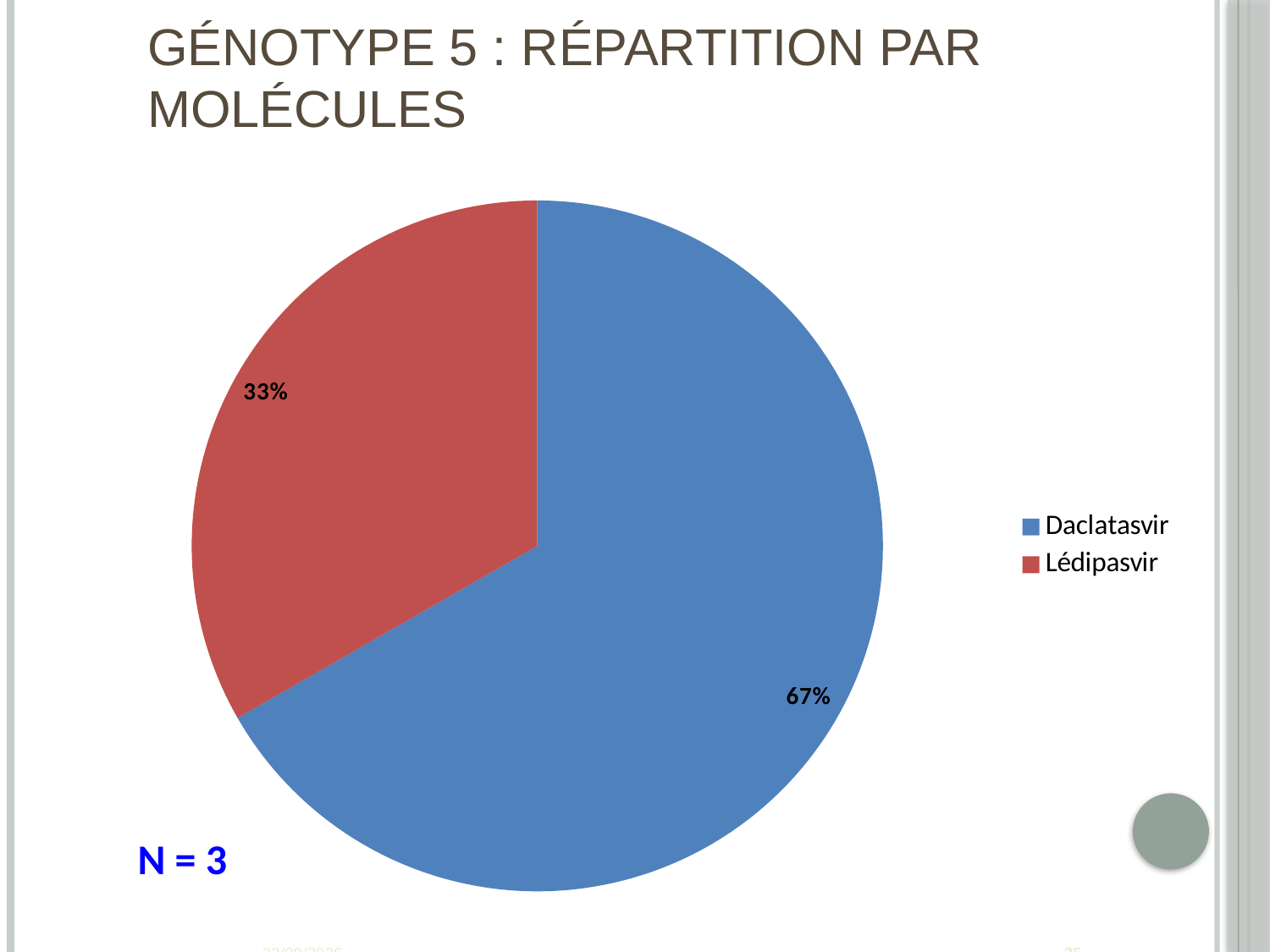
What colour is the Lédipasvir slice? red What is the value of N shown on the slide? 3 Which molecule has the largest share of the pie? Daclatasvir What is the difference in percentage points between the Daclatasvir and Lédipasvir slices? 34 Is the share for Daclatasvir greater or less than 50%? greater Which slice is larger, Daclatasvir or Lédipasvir? Daclatasvir What percentage of the pie does Lédipasvir represent? 33% How many slices does the pie chart have? 2 How many entries does the legend list? 2 What percentage of the pie does Daclatasvir represent? 67% Which molecule has the smallest share of the pie? Lédipasvir What kind of chart is shown on the slide? pie chart